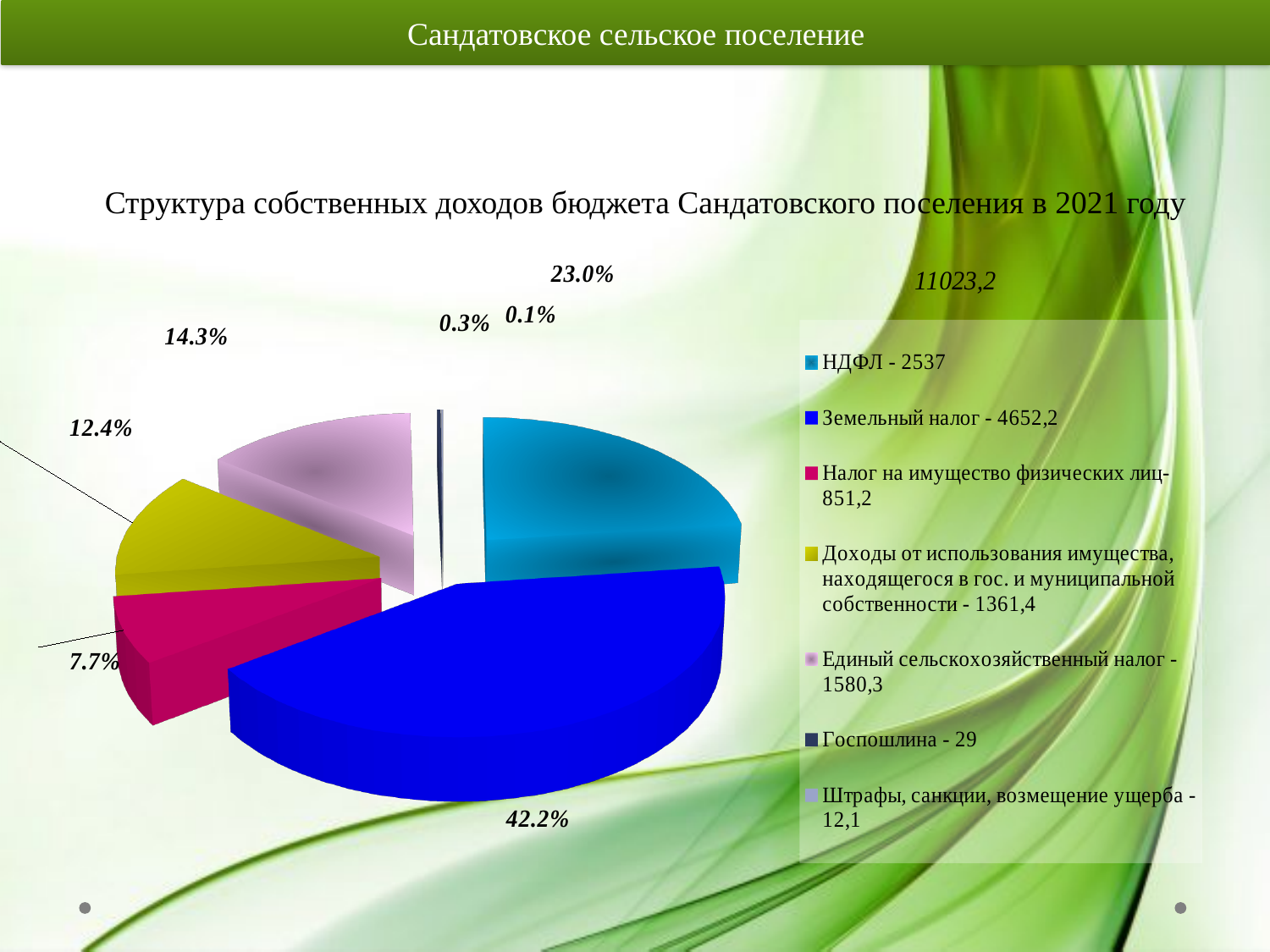
How many slices does the pie chart have? 7 Which category has the smallest slice of the pie? Штрафы, санкции, возмещение ущерба What kind of chart is shown on the slide? pie chart Which is larger: the value for НДФЛ or the value for Единый сельскохозяйственный налог? НДФЛ How many entries does the legend list? 7 What value is given in the legend for Налог на имущество физических лиц? 851,2 What share of the pie does НДФЛ take? 23.0% Which category has the largest slice of the pie? Земельный налог What value is given in the legend for Госпошлина? 29 What share of the pie does Земельный налог take? 42.2% What share of the pie does Единый сельскохозяйственный налог take? 14.3%